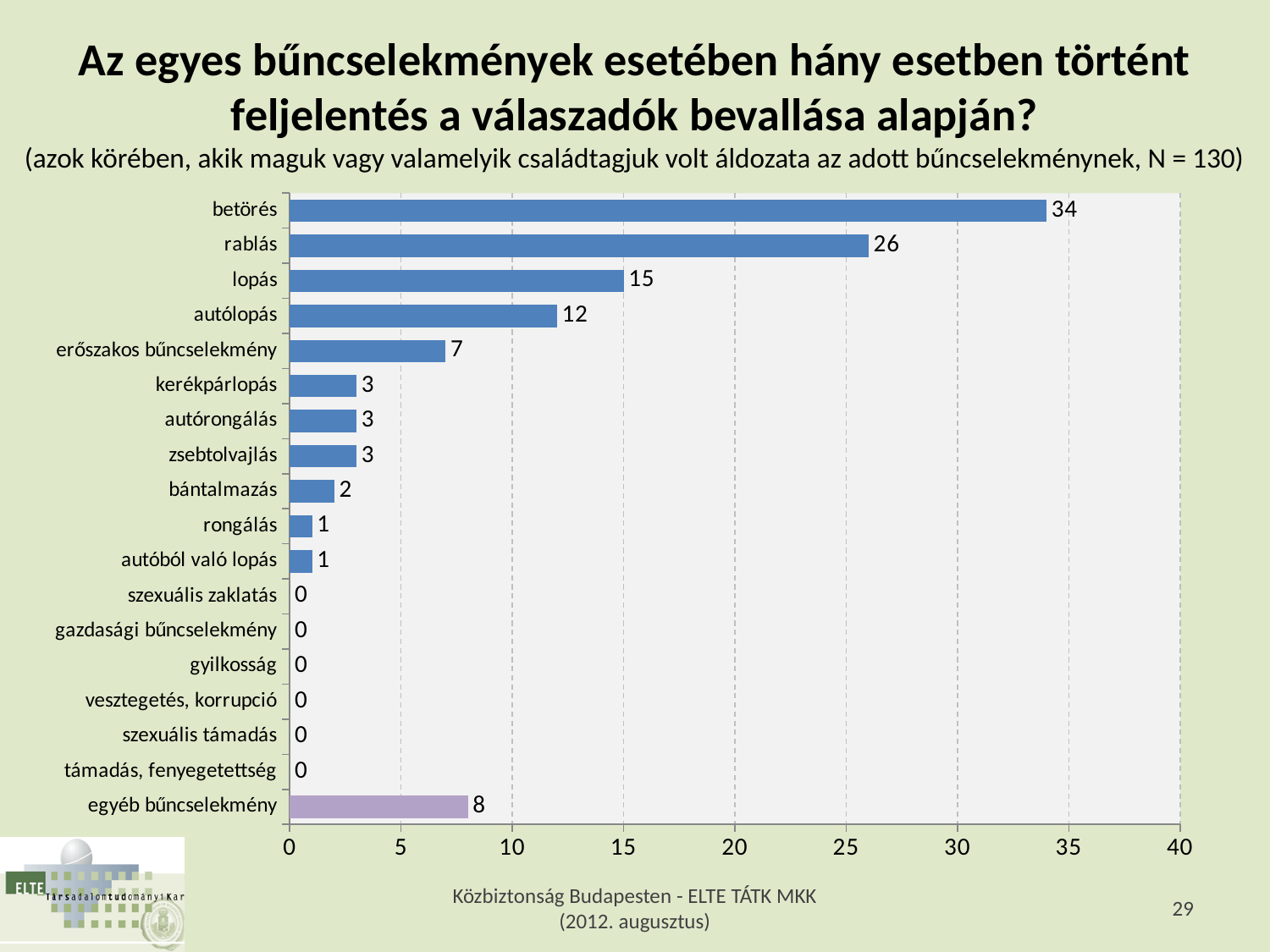
What is the maximum value shown on the x axis? 40 How many categories are shown on the chart? 18 Is the value for rablás greater or less than 25? greater What is the value for egyéb bűncselekmény? 8 What is the value for autólopás? 12 What is the difference between the values for betörés and rablás? 8 How many categories have a value of 0? 6 Which category has the highest value? betörés What kind of chart is shown on the slide? bar chart What is the difference between the values for lopás and erőszakos bűncselekmény? 8 What is the value for betörés? 34 Which is larger, the value for rablás or the value for lopás? rablás